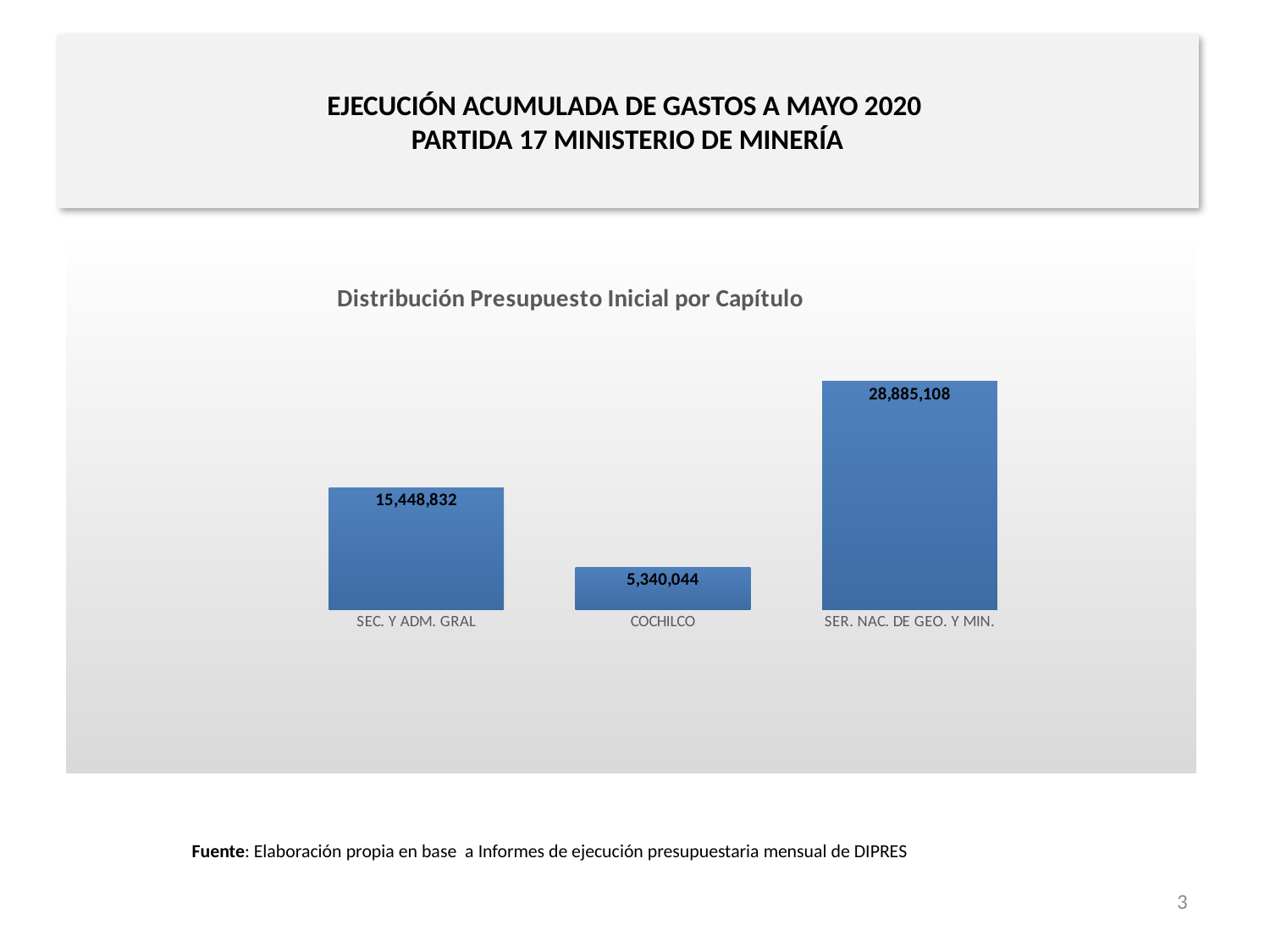
What is the value for SER. NAC. DE GEO. Y MIN.? 28,885,108 What is the difference between the values for SEC. Y ADM. GRAL and COCHILCO? 10,108,788 How many categories are shown in the chart? 3 What is the value for SEC. Y ADM. GRAL? 15,448,832 What is the difference between the values for SER. NAC. DE GEO. Y MIN. and COCHILCO? 23,545,064 Which is larger, the value for SEC. Y ADM. GRAL or the value for COCHILCO? SEC. Y ADM. GRAL What is the title of the chart? Distribución Presupuesto Inicial por Capítulo What is the difference between the values for SER. NAC. DE GEO. Y MIN. and SEC. Y ADM. GRAL? 13,436,276 What is the value for COCHILCO? 5,340,044 What kind of chart is shown on the slide? Bar chart Which category has the lowest value? COCHILCO Which category has the highest value? SER. NAC. DE GEO. Y MIN.